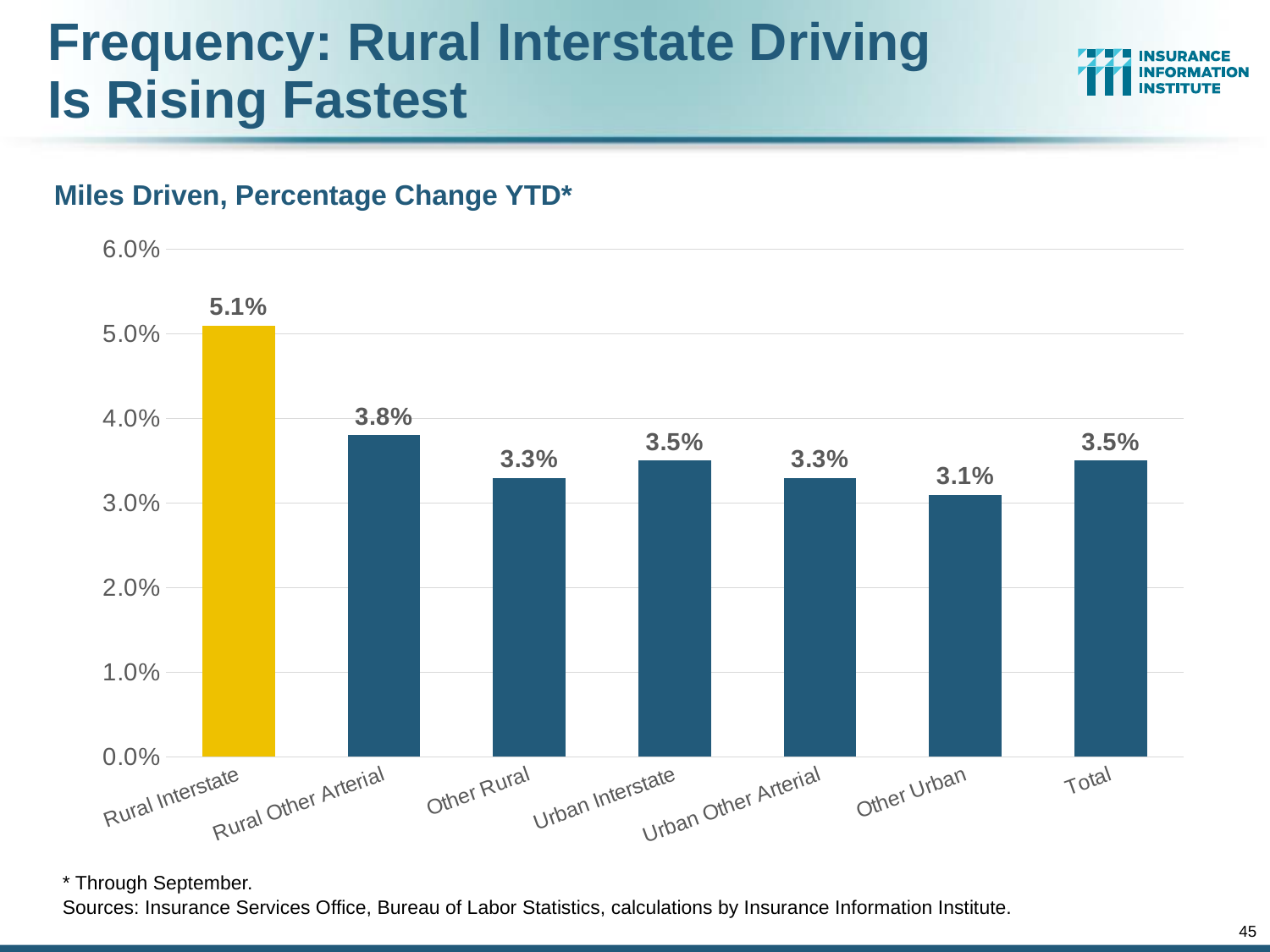
Is the value for Rural Interstate greater or less than 5.0%? greater What is the percentage change in miles driven for the Total category? 3.5% Which is larger, the percentage change for Urban Interstate or Other Urban? Urban Interstate What kind of chart is shown on the slide? Bar chart What is the percentage change in miles driven for Rural Interstate? 5.1% What is the percentage change in miles driven for Other Urban? 3.1% Which category has the lowest percentage change in miles driven? Other Urban Which bar is highlighted in a different colour (yellow) from the others? Rural Interstate How many categories are shown on the chart? 7 Which category has the highest percentage change in miles driven? Rural Interstate What is the difference between the percentage change for Rural Interstate and Rural Other Arterial? 1.3% What is the percentage change in miles driven for Rural Other Arterial? 3.8%